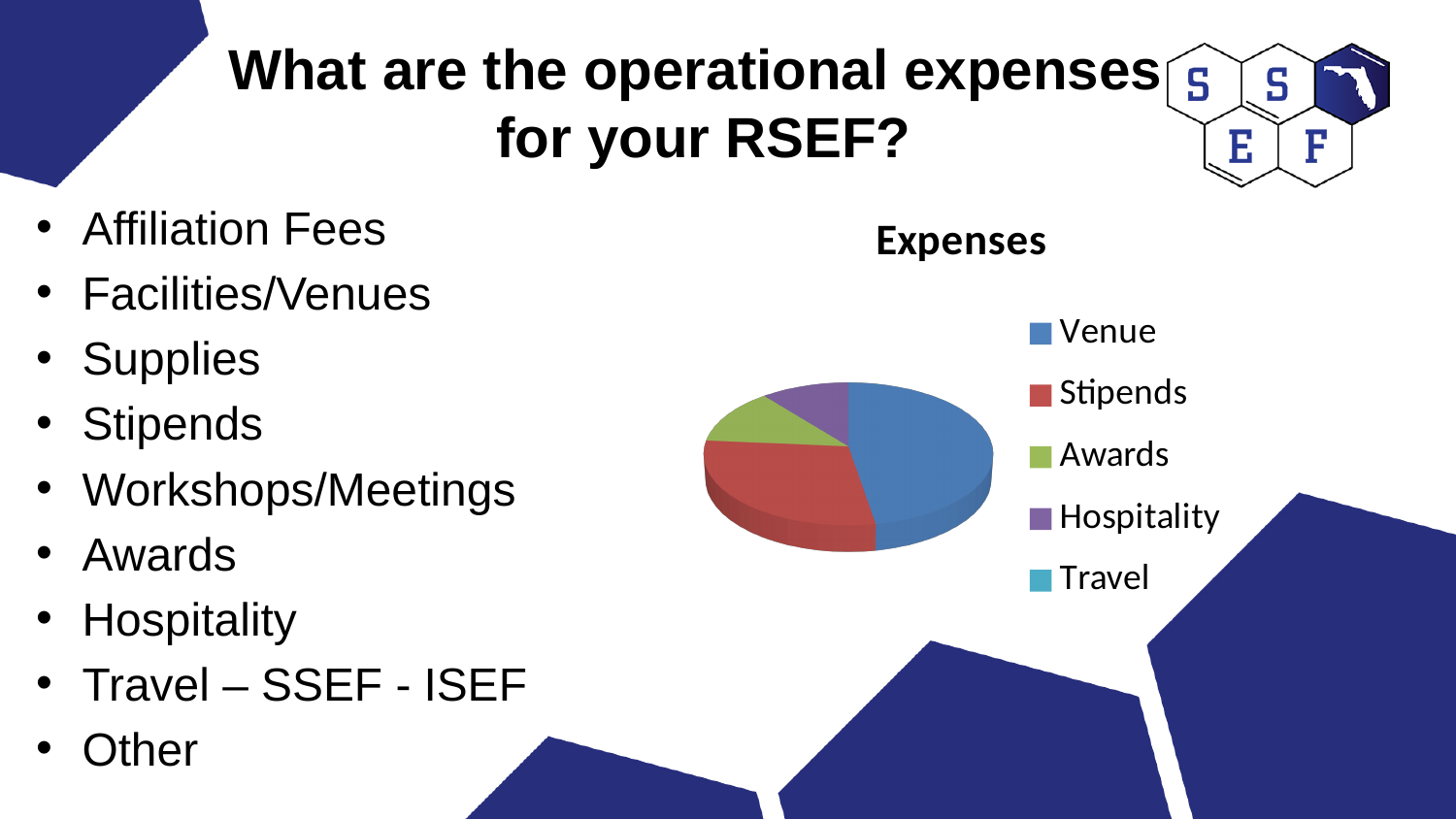
Which slice is larger, Stipends or Awards? Stipends What is the title of the chart? Expenses Which legend entry is listed last in the chart's legend? Travel Which slice is larger, Stipends or Hospitality? Stipends Which slice is larger, Venue or Stipends? Venue Which expense category has the largest slice of the pie? Venue What kind of chart is shown on the slide? pie chart How many categories does the chart's legend list? 5 What colour is the Venue slice in the pie chart? blue